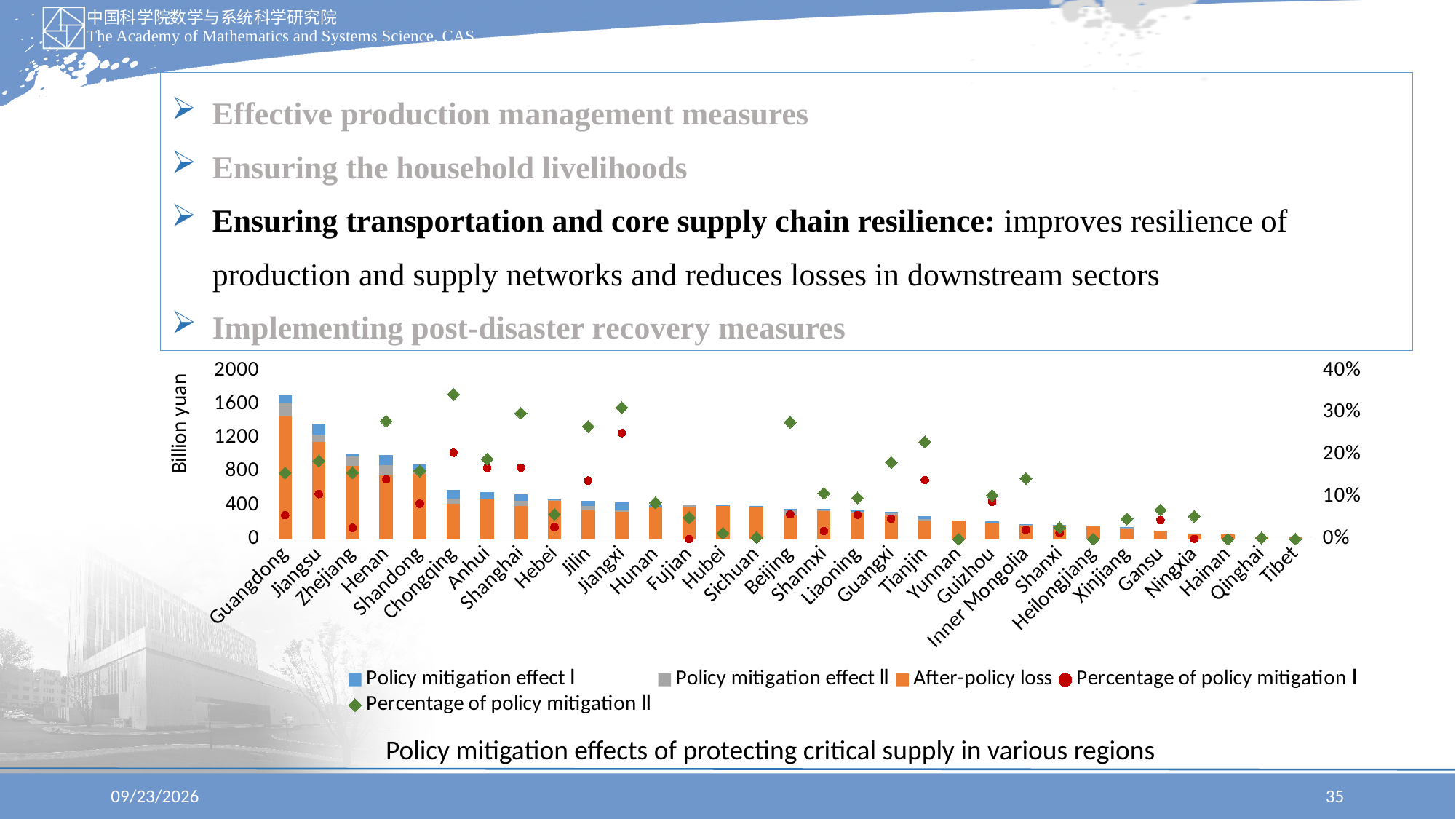
Is the total stacked bar for Tibet greater or less than 400 billion yuan? less What is the label on the left vertical axis of the chart? Billion yuan Is the Percentage of policy mitigation II for Chongqing greater or less than 30%? greater Which region has the larger total stacked bar, Guangdong or Jiangsu? Guangdong What kind of chart is shown on the slide? bar chart (stacked bars with percentage markers) Which region has the highest value for Percentage of policy mitigation II? Chongqing Is the total stacked bar for Guangdong greater or less than 1600 billion yuan? greater How many regions are shown along the x axis of the chart? 31 How many series does the chart legend list? 5 Which region has the highest value for Percentage of policy mitigation I? Jiangxi Which region has the tallest stacked bar in the chart? Guangdong Do the stacked bar totals generally rise or fall from left to right along the x axis? fall